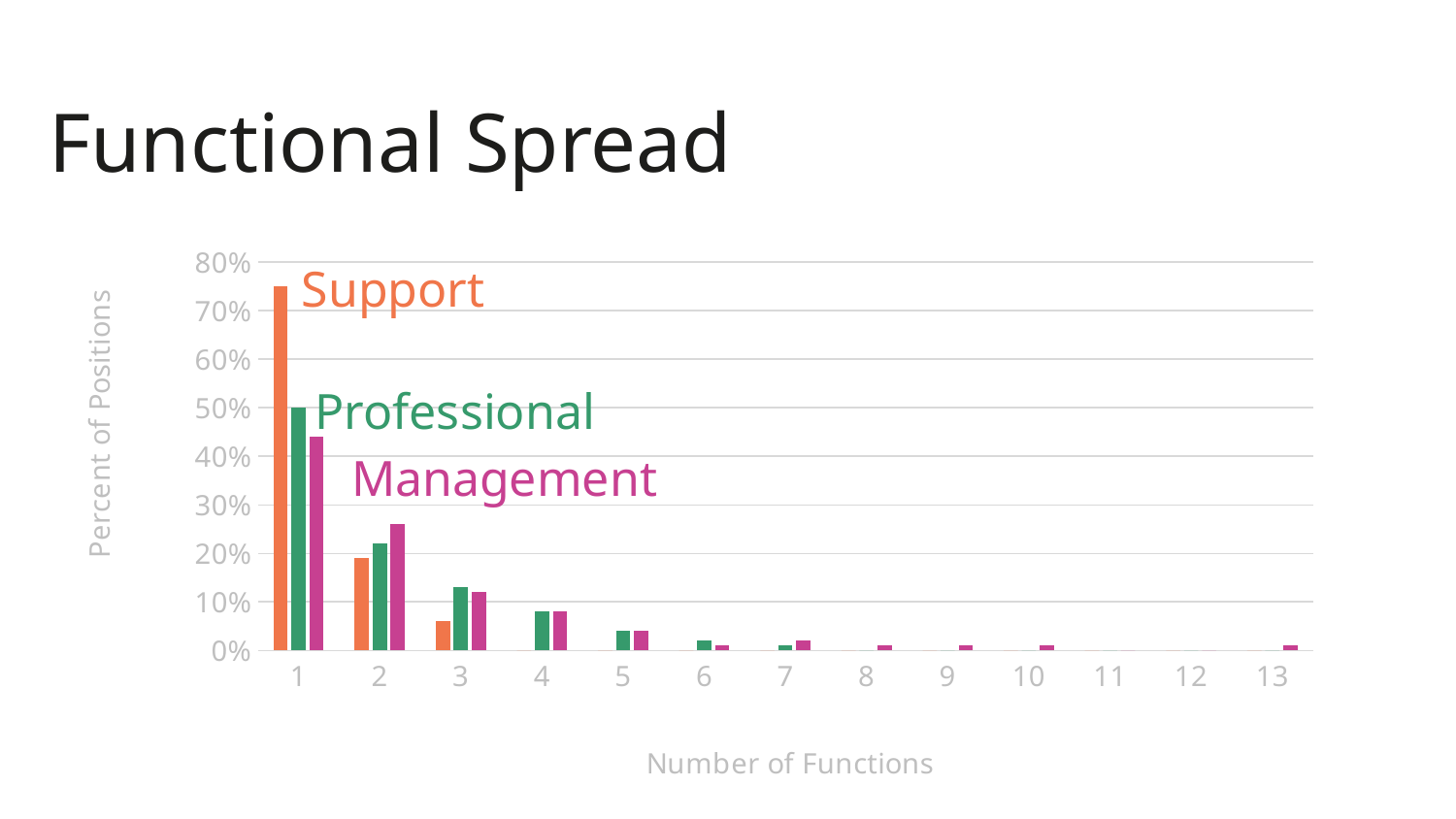
Which series has the lowest value at 1 function? Management Is the value for Management at 1 function greater or less than 40%? greater Do the Support values rise or fall as the number of functions increases? fall At 2 functions, which is larger: Support or Management? Management Is the value for Support at 3 functions greater or less than 10%? less At 3 functions, which is larger: Support or Professional? Professional Is the value for Management at 2 functions greater or less than 20%? greater Which series has the highest value at 1 function? Support What kind of chart is shown on the slide? bar chart How many series does the chart show? 3 How many categories are shown on the x axis (Number of Functions)? 13